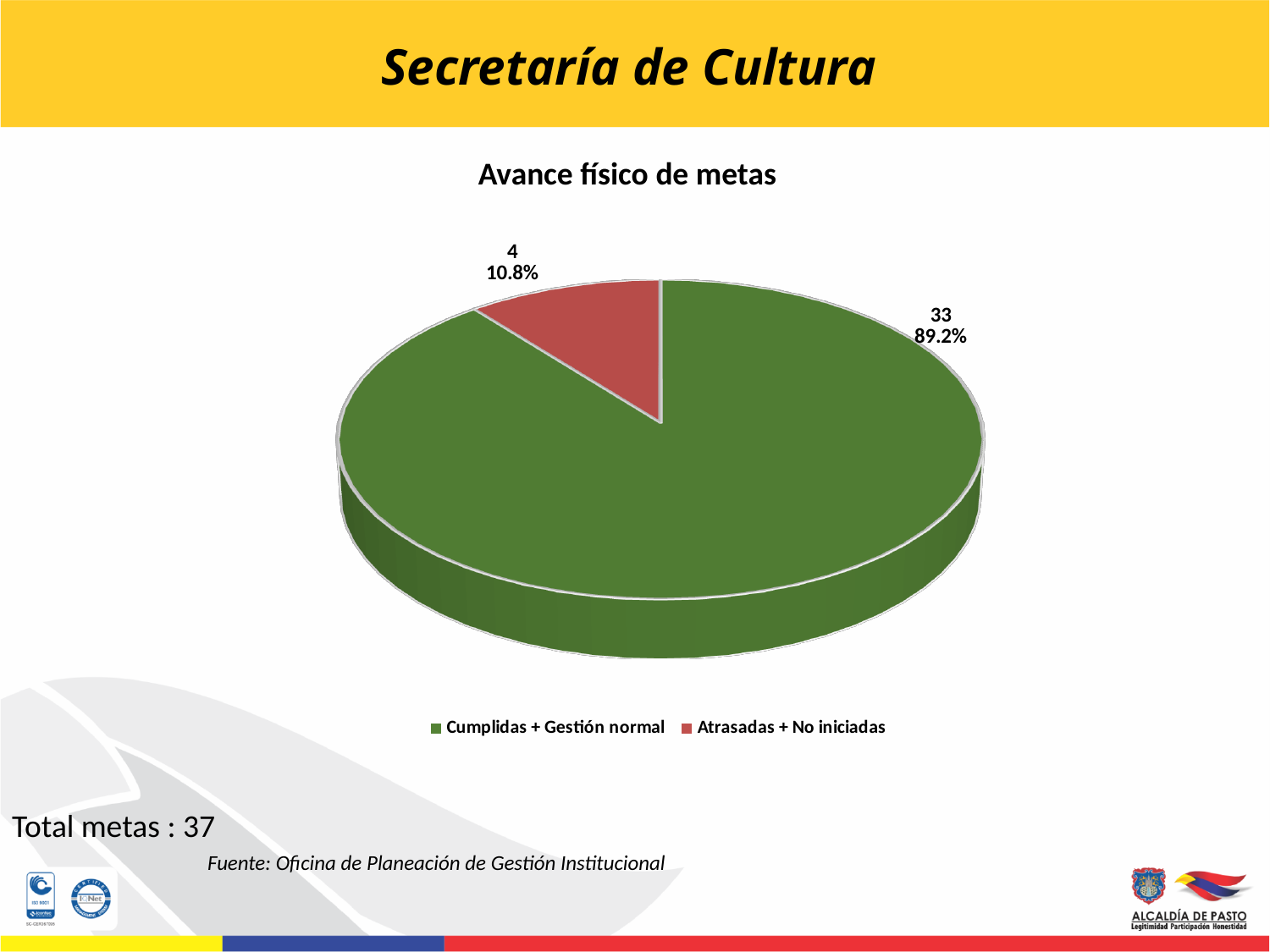
Which category has the smallest slice? Atrasadas + No iniciadas What colour is the slice for Atrasadas + No iniciadas? red What is the title of the chart? Avance físico de metas How many entries does the legend list? 2 What is the value for Cumplidas + Gestión normal? 33 What is the difference between the values for Cumplidas + Gestión normal and Atrasadas + No iniciadas? 29 What share of the pie does Atrasadas + No iniciadas represent? 10.8% Which category has the largest slice? Cumplidas + Gestión normal What share of the pie does Cumplidas + Gestión normal represent? 89.2% How many slices does the pie chart have? 2 What is the value for Atrasadas + No iniciadas? 4 What kind of chart is shown on the slide? pie chart